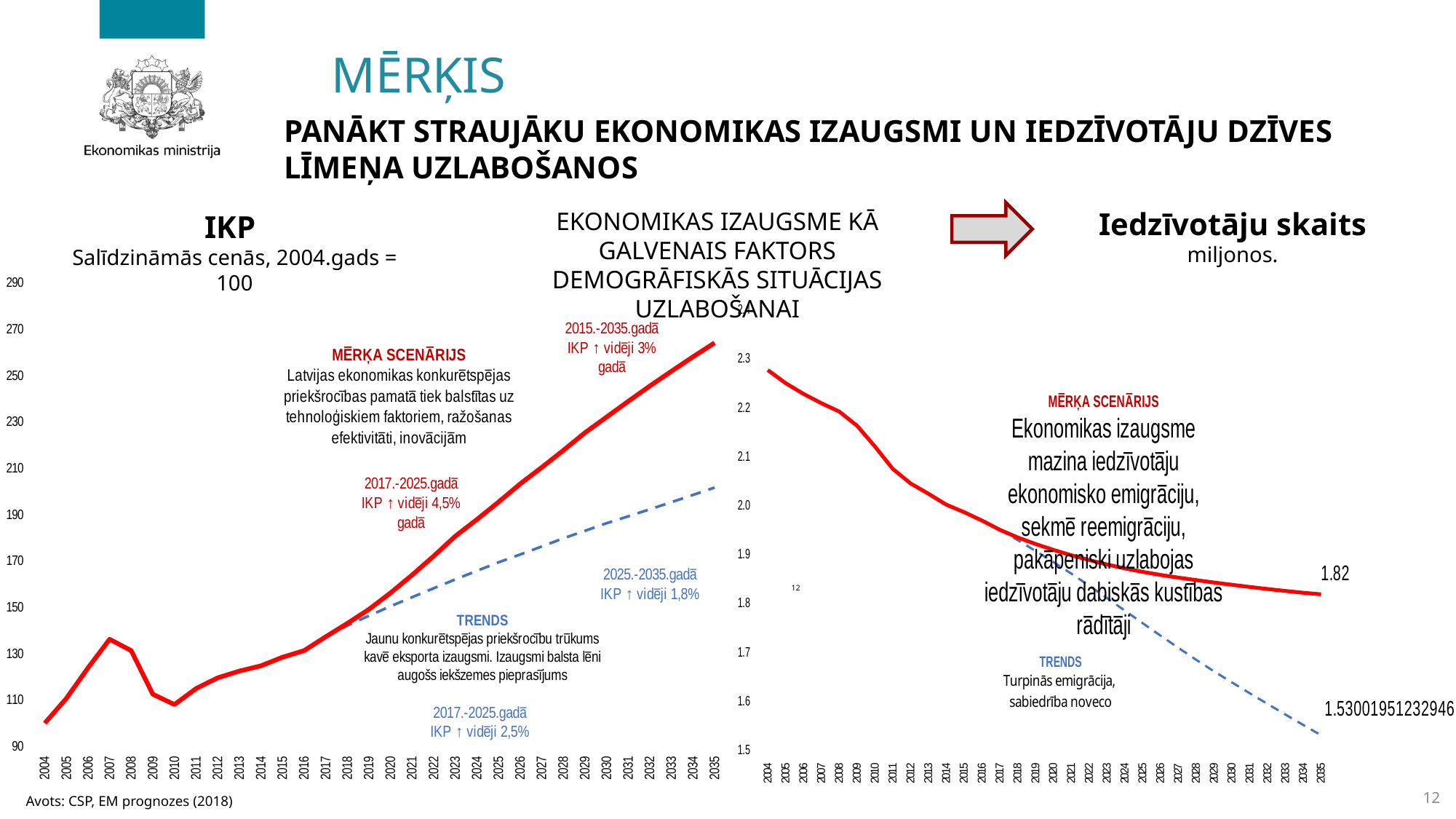
In the Iedzīvotāju skaits chart, what value is labelled at the end of the blue dashed line in 2035? 1.53001951232946 What kind of chart is the Iedzīvotāju skaits chart on the right of the slide? line chart In the IKP chart, is the value of the blue dashed line in 2035 greater or less than 210? less In the Iedzīvotāju skaits chart, what value is labelled at the end of the red line in 2035? 1.82 What kind of chart is the IKP chart on the left of the slide? line chart How many years are shown on the x axis of the IKP chart? 32 In the IKP chart, is the value of the red line in 2035 greater or less than 250? greater In the Iedzīvotāju skaits chart, does the red line rise or fall from 2004 to 2035? fall In the Iedzīvotāju skaits chart, which line ends higher in 2035, the red line or the blue dashed line? the red line In the Iedzīvotāju skaits chart, is the value in 2004 greater or less than 2.2? greater What is the title of the chart on the right of the slide? Iedzīvotāju skaits In the IKP chart, does the red line rise or fall overall from 2004 to 2035? rise